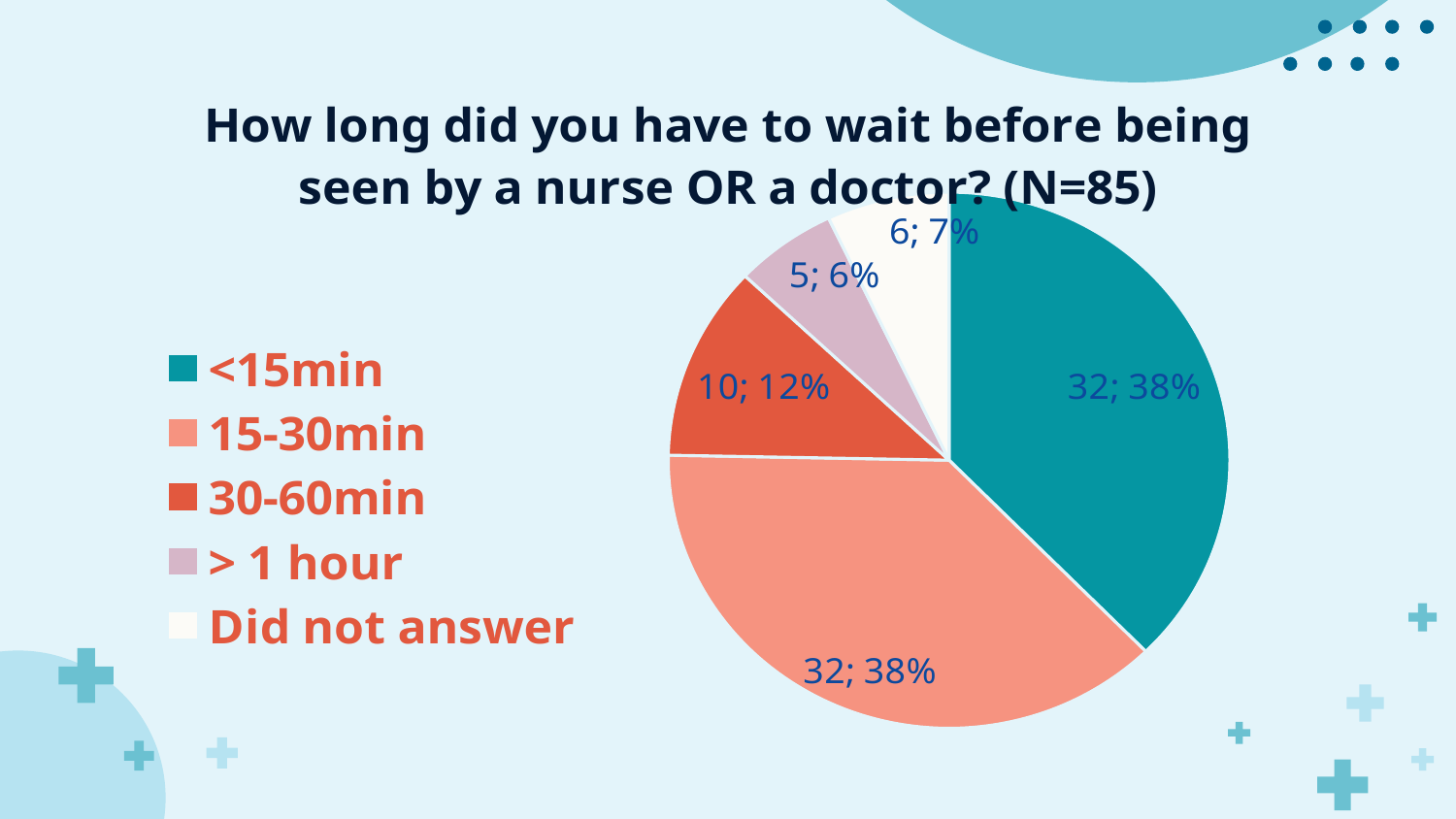
What is the difference between the number of respondents who waited 30-60min and those who waited > 1 hour? 5 How many respondents did not answer? 6 Which is larger, the number of respondents who waited 30-60min or the number who waited > 1 hour? 30-60min What kind of chart is shown on the slide? pie chart What is the title of the chart? How long did you have to wait before being seen by a nurse OR a doctor? (N=85) How many categories does the pie chart have? 5 Which category has the smallest slice of the pie? > 1 hour How many respondents waited less than 15 minutes (<15min)? 32 What percentage of respondents waited 15-30min? 38% What percentage of respondents waited more than 1 hour (> 1 hour)? 6% What share of the pie does the 'Did not answer' slice represent? 7% How many respondents waited 30-60min? 10